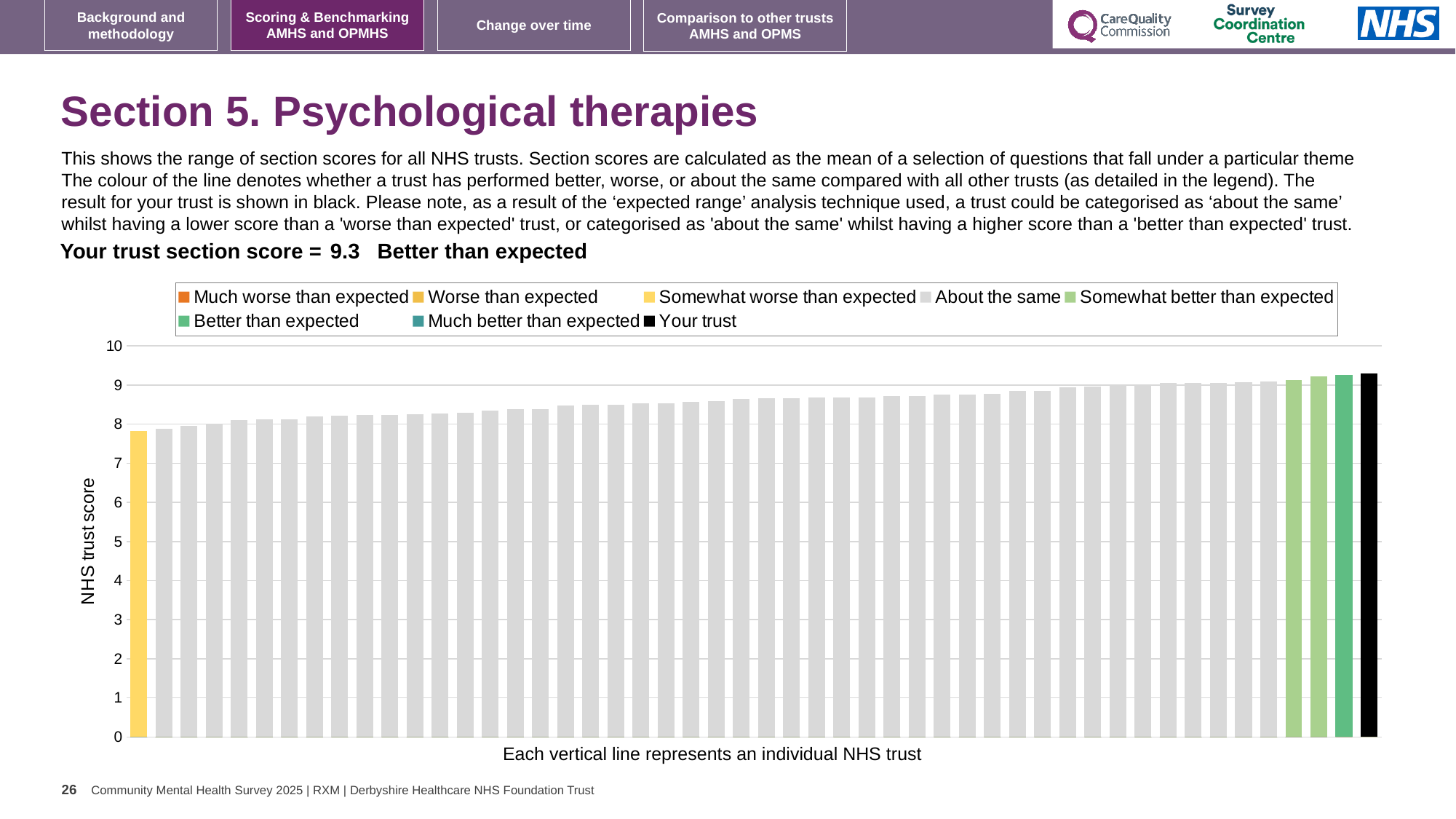
What kind of chart is shown on the slide? bar chart Is the value of the leftmost (yellow) bar greater or less than 9? less What colour is the bar representing your trust? black How many bars are shown in the 'Somewhat better than expected' colour? 2 How many entries does the chart legend list? 8 Is the value of the black 'Your trust' bar greater or less than 9? greater Do the bar values rise or fall moving from left to right along the x axis? rise What is the label on the vertical axis of the chart? NHS trust score What is the section score for your trust shown on the slide? 9.3 Which category is your trust's section score placed in, according to the text above the chart? Better than expected